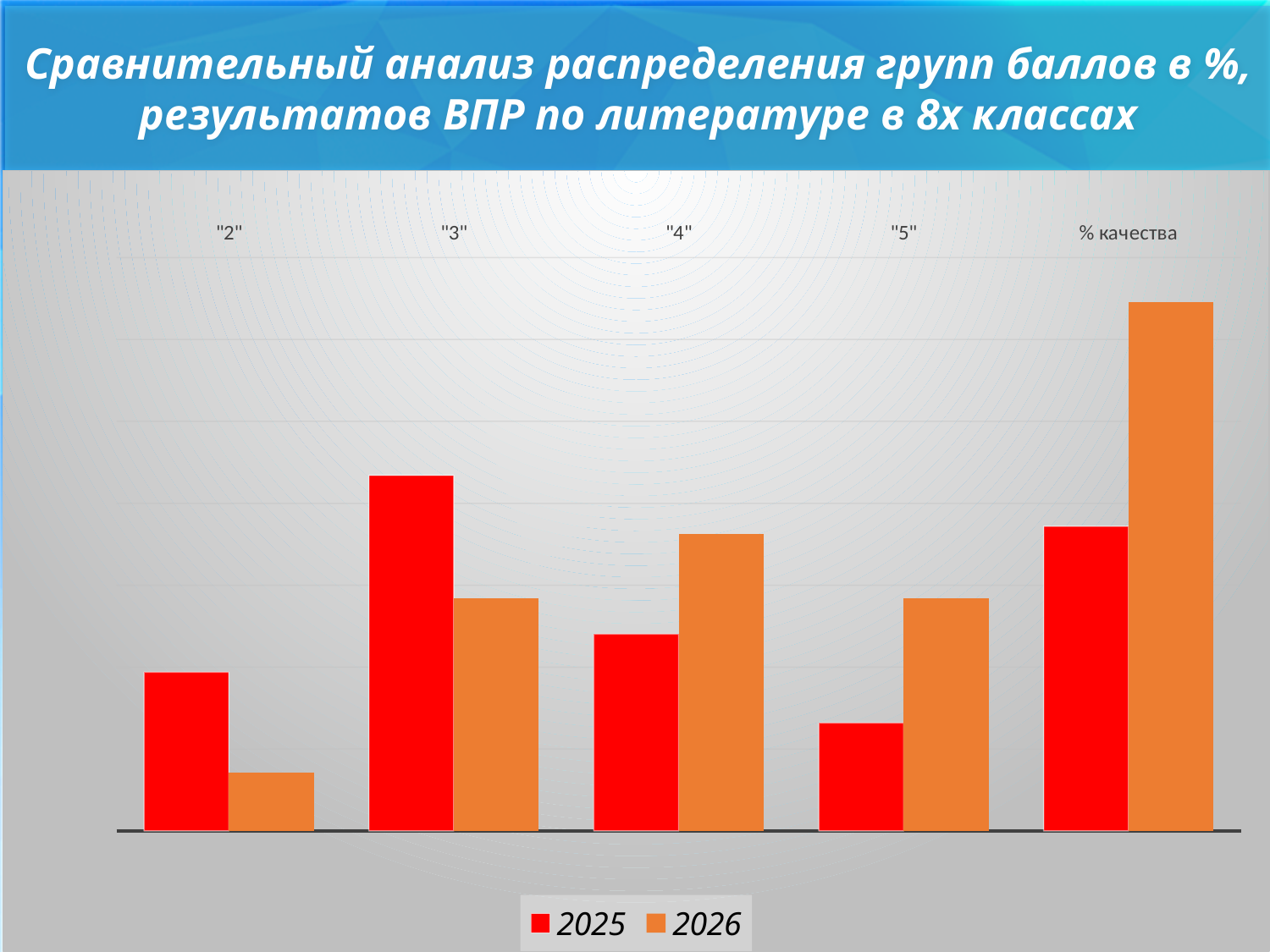
Which colour represents the 2026 series in the legend? Orange Which series has the larger value for category "2", 2025 or 2026? 2025 Which series has the larger value for category "3", 2025 or 2026? 2025 How many categories are shown along the x axis of the chart? 5 Which series has the larger value for category "4", 2025 or 2026? 2026 How many series does the legend list? 2 What kind of chart is shown on the slide? Bar chart For the 2026 series, which category has the highest bar? % качества For the 2025 series, which category has the lowest bar? "5" For the 2025 series, which category has the highest bar? "3"